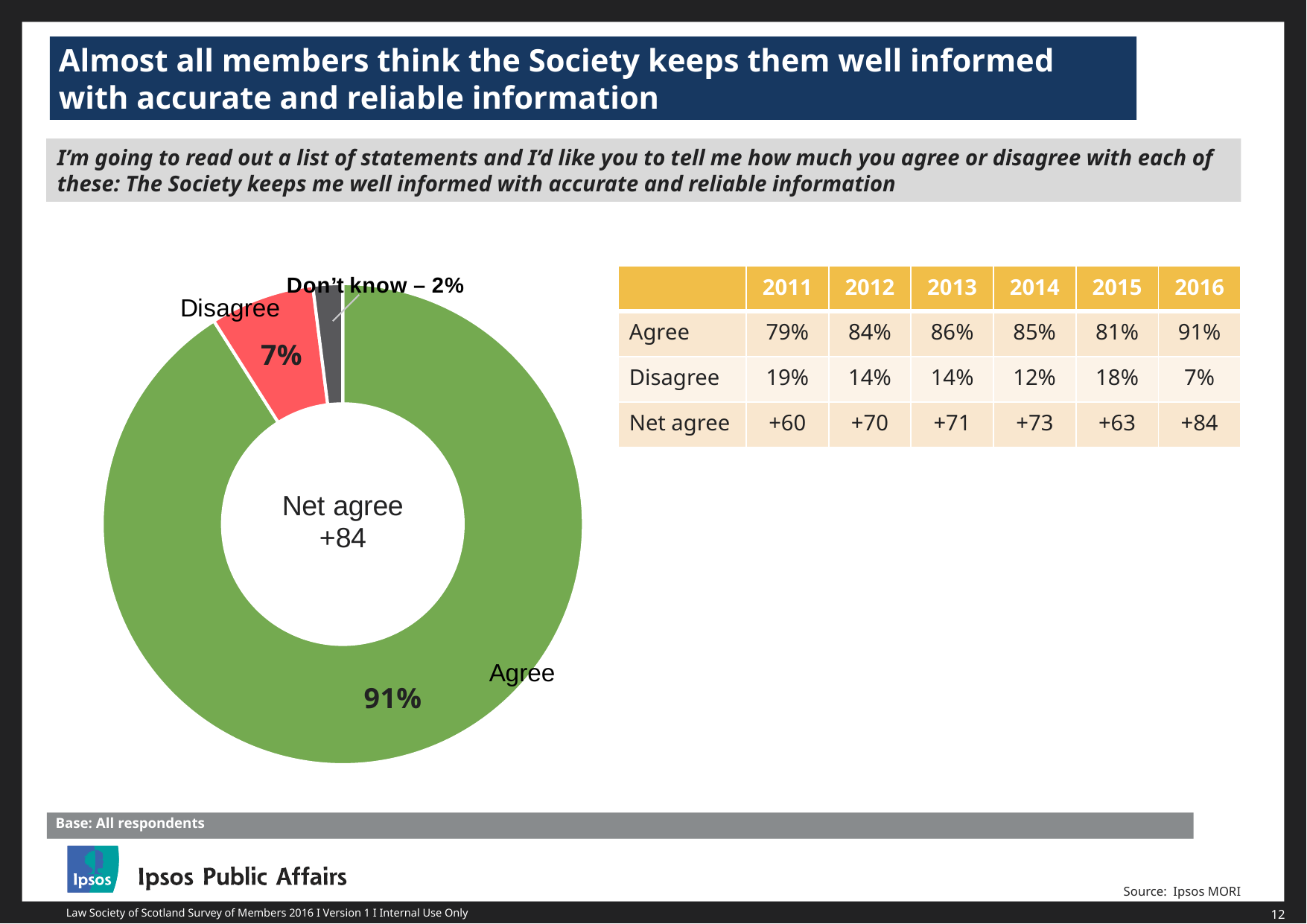
What type of chart is used to show the responses? Donut (pie) chart How many response categories are shown in the donut chart? 3 What colour is the Agree slice in the donut chart? Green Which response category has the largest slice of the donut chart? Agree What is the difference in percentage points between Agree and Disagree in the donut chart? 84 What percentage of members answered 'Don't know'? 2% What share of the donut chart does the Agree slice represent? 91% Which response category has the smallest slice of the donut chart? Don't know What percentage of members disagree? 7% What percentage of members agree that the Society keeps them well informed with accurate and reliable information? 91% What is the net agree figure shown in the centre of the donut chart? +84 Which is larger in the donut chart, Disagree or Don't know? Disagree